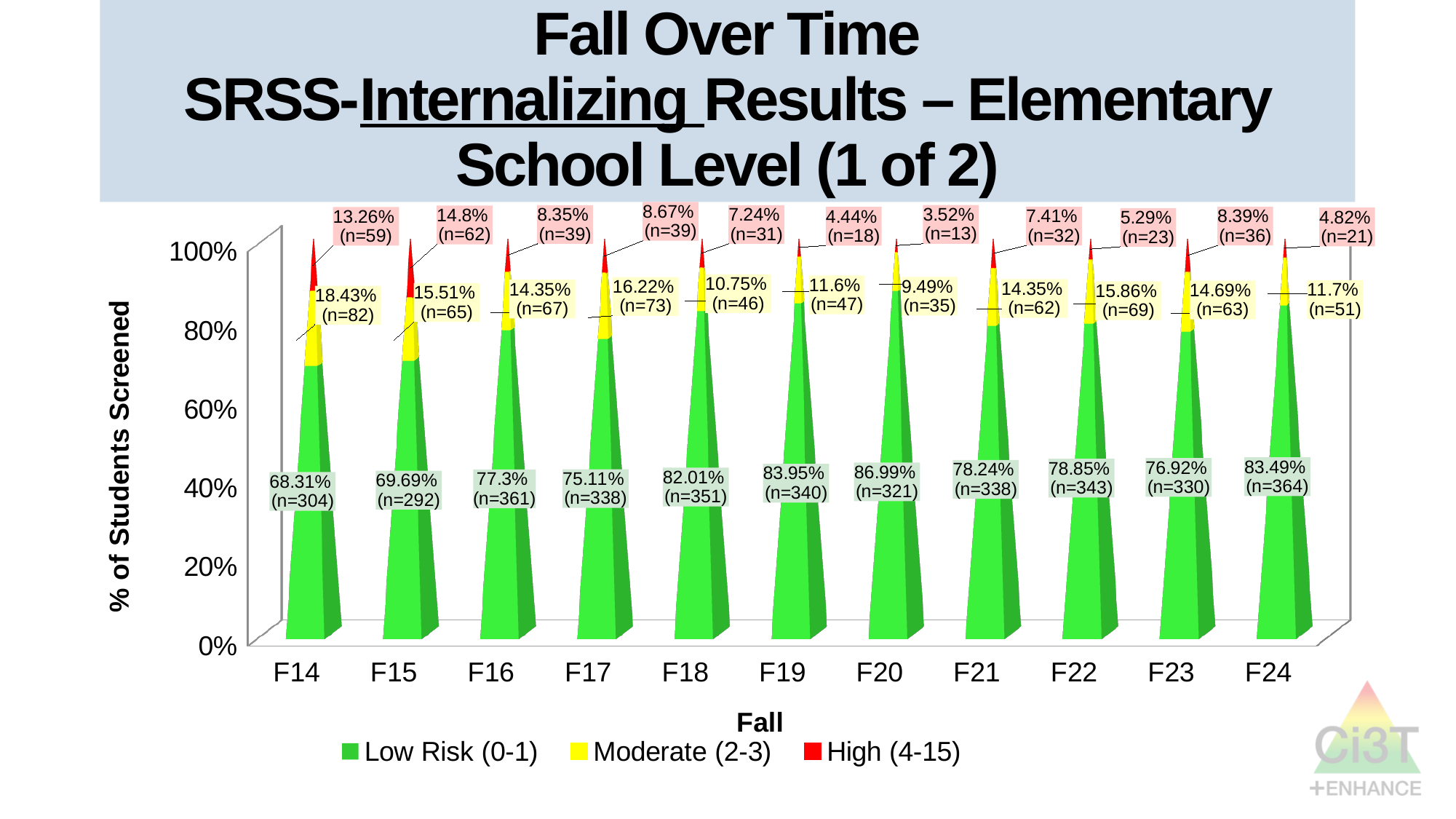
What kind of chart is shown on the slide? Stacked bar chart What percentage of students screened were High (4-15) in F14? 13.26% What is the difference between the Low Risk (0-1) percentage in F24 and in F14? 15.18% Which fall has the highest High (4-15) percentage? F15 How many series does the legend list? 3 Which is larger, the High (4-15) percentage in F14 or in F15? F15 How many students were in the Moderate (2-3) category in F17? n=73 Which fall has the lowest High (4-15) percentage? F20 What percentage of students screened were Low Risk (0-1) in F20? 86.99% Which fall has the lowest Low Risk (0-1) percentage? F14 Which fall has the highest Low Risk (0-1) percentage? F20 How many fall time points are shown on the x axis? 11